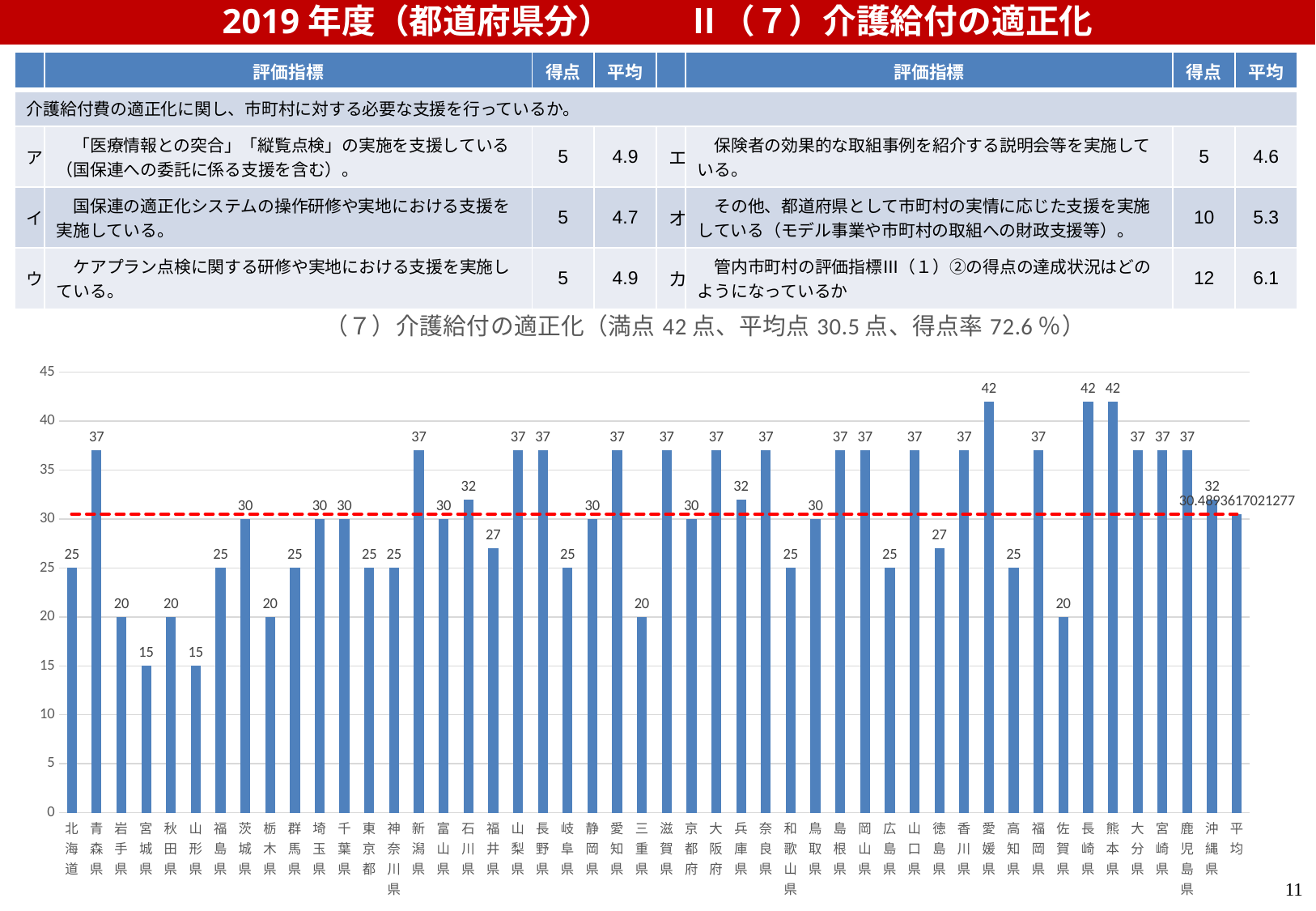
What is the 平均点 stated in the chart title? 30.5 点 What type of chart is shown on the slide? bar chart Is the value for 佐賀県 greater or less than 25? less What is the highest value shown in the bar chart? 42 What is the difference between the values for 石川県 and 福井県? 5 What is the value for 徳島県 in the bar chart? 27 What is the difference between the values for 愛媛県 and 北海道? 17 Which prefectures have the lowest value in the bar chart? 宮城県 and 山形県 Which has a larger value, 新潟県 or 富山県? 新潟県 What is the value for 沖縄県 in the bar chart? 32 How many bars are plotted in the chart, including the 平均 bar? 48